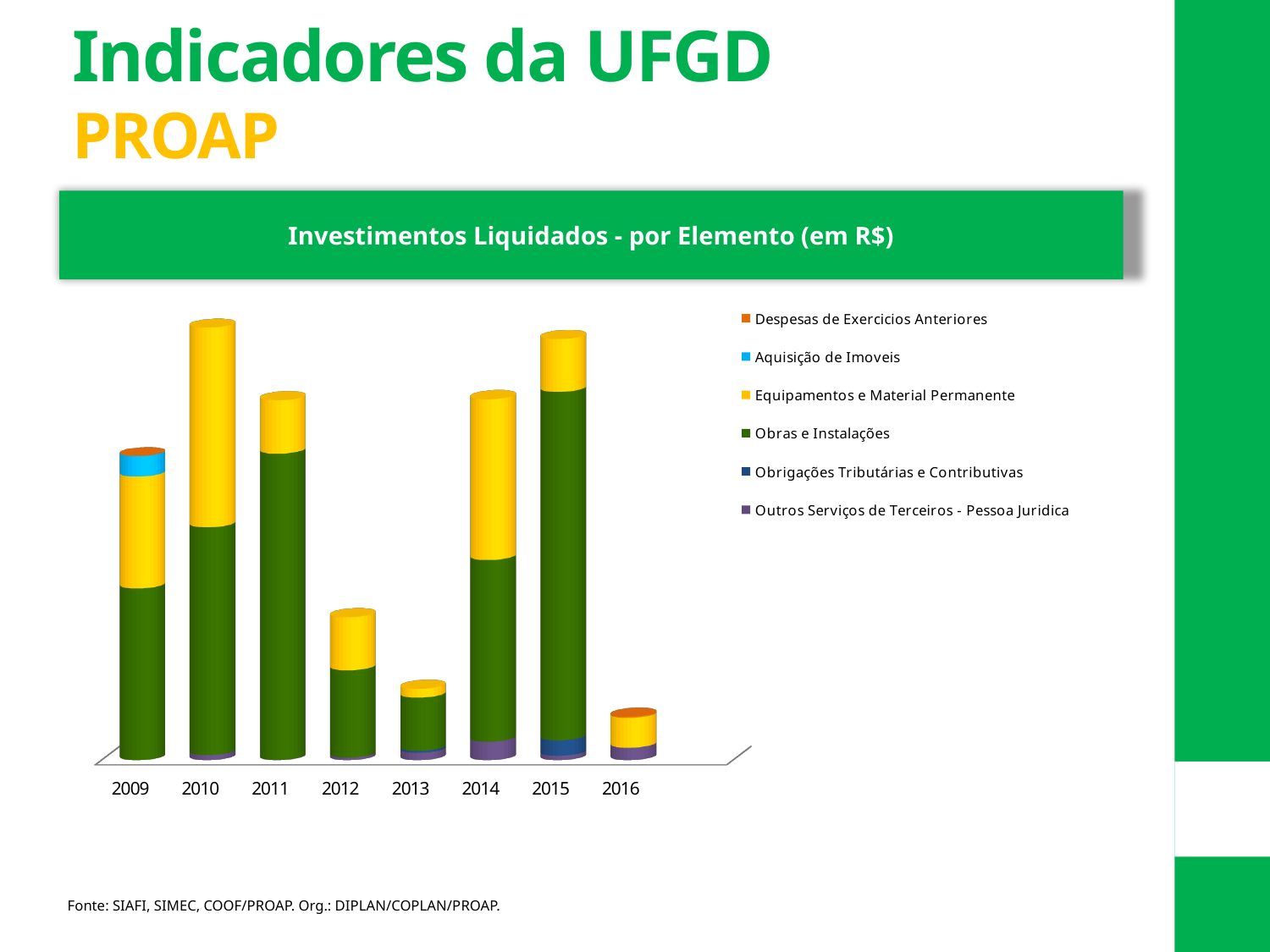
What is the title of the chart? Investimentos Liquidados - por Elemento (em R$) Which year has the taller stacked bar, 2013 or 2014? 2014 How many series does the legend list? 6 Which year has the shortest stacked bar? 2016 Do the total bar heights rise or fall from 2010 to 2013? Fall Which year has the tallest stacked bar? 2010 What kind of chart is shown on the slide? Stacked bar chart How many years are shown on the x axis of the chart? 8 Which series makes up the largest part of the 2015 bar? Obras e Instalações Do the total bar heights rise or fall from 2013 to 2015? Rise Which series is shown in light blue in the legend? Aquisição de Imoveis Which year has the taller stacked bar, 2011 or 2012? 2011